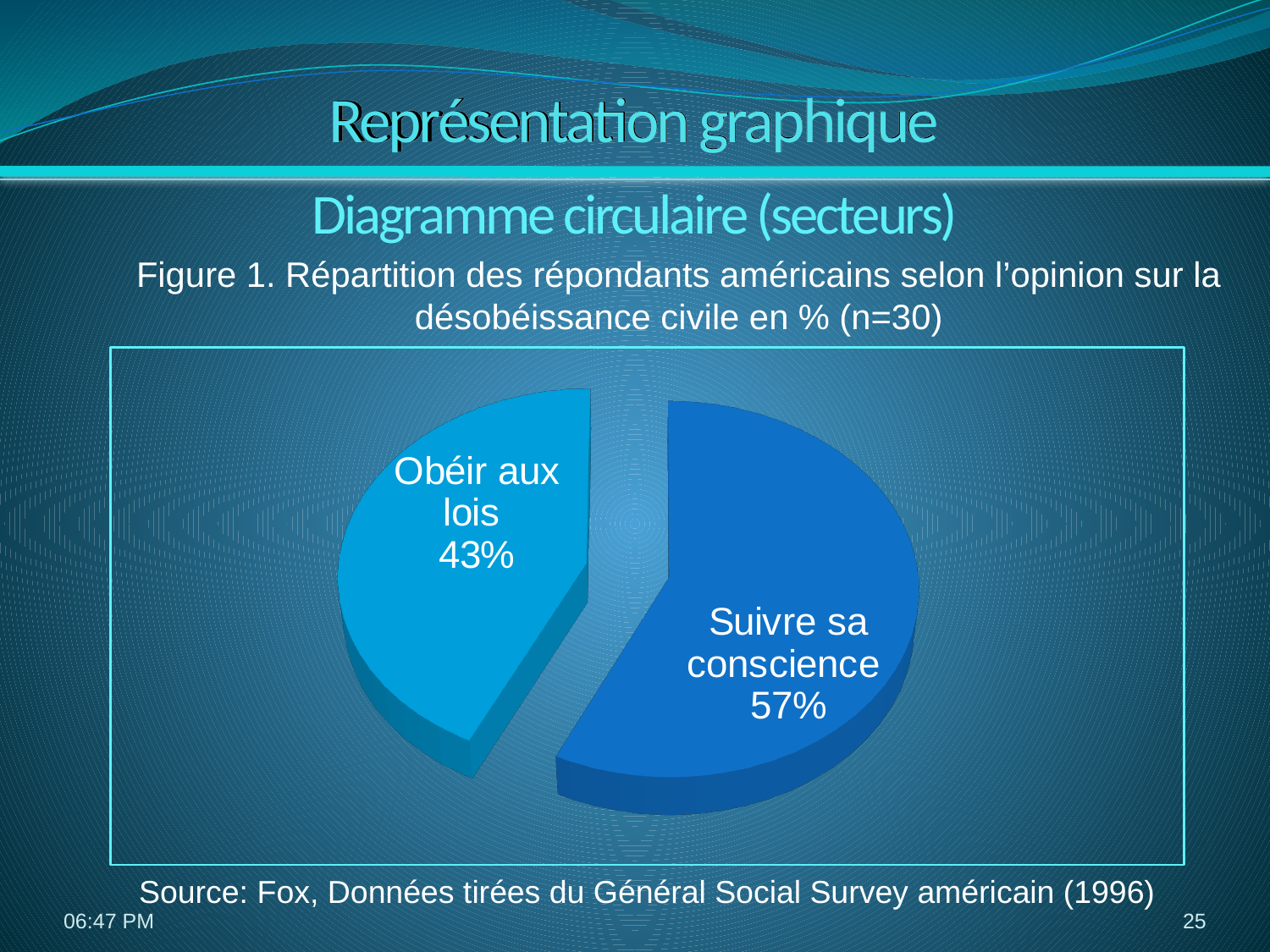
What share of the pie does "Obéir aux lois" represent? 43% What percentage of respondents chose "Obéir aux lois"? 43% How many categories are shown in the pie chart? 2 Which category has the smallest share of the pie? Obéir aux lois What kind of chart is shown on the slide? Pie chart What is the source of the data cited below the chart? Fox, Données tirées du Général Social Survey américain (1996) What is the difference in percentage points between "Suivre sa conscience" and "Obéir aux lois"? 14 What is the sample size (n) stated in the figure title? 30 Which category has the largest share of the pie? Suivre sa conscience Which is larger: the share for "Obéir aux lois" or the share for "Suivre sa conscience"? Suivre sa conscience What percentage of respondents chose "Suivre sa conscience"? 57%